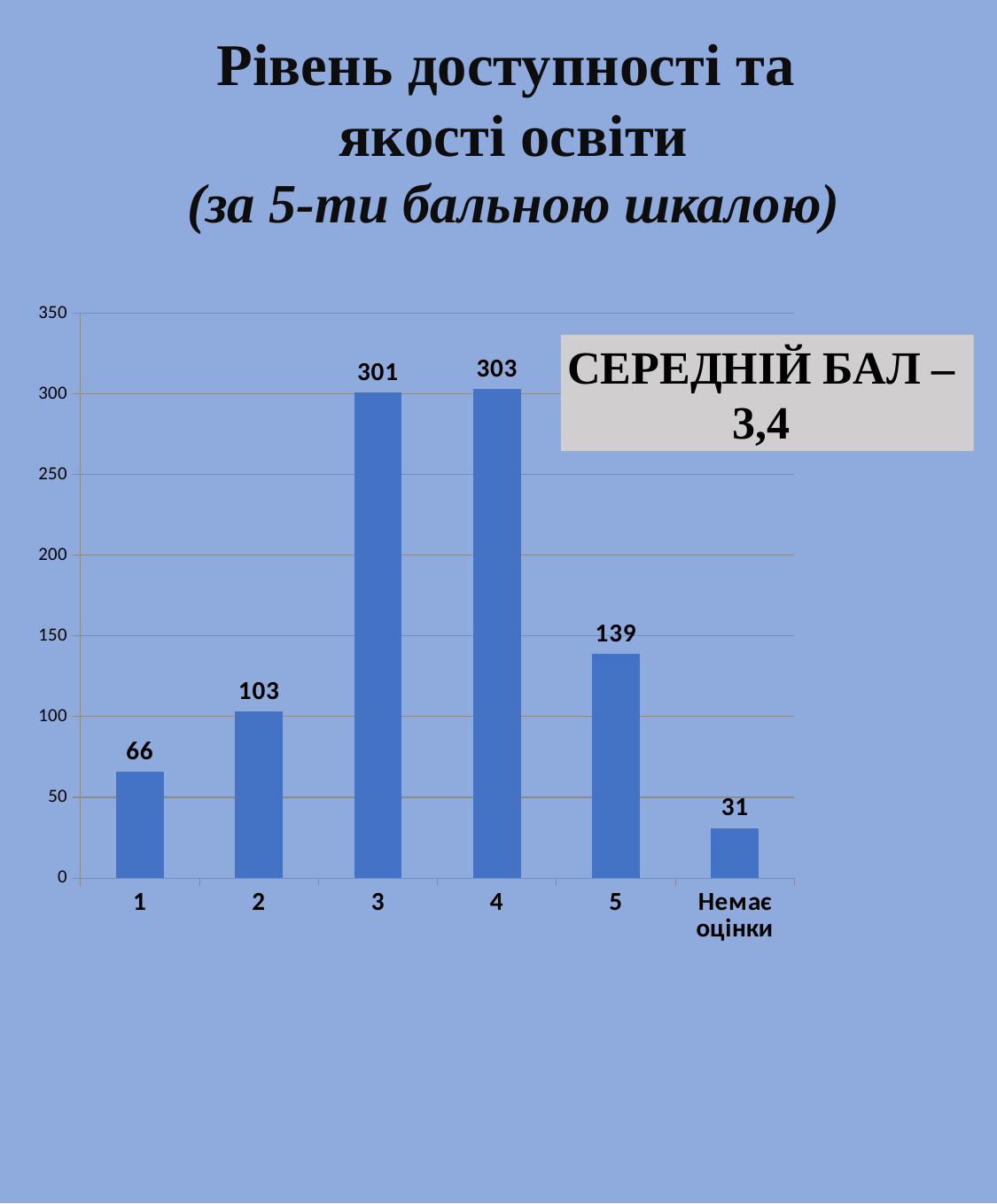
What kind of chart is shown on the slide? bar chart Which category has the highest value? 4 Which is larger, the value for category 2 or the value for category 5? 5 How many categories are shown on the x axis? 6 What is the value for category 5? 139 What is the value for the "Немає оцінки" category? 31 Is the value for category 1 greater or less than 50? greater Which category has the lowest value? Немає оцінки What is the value for category 3? 301 What is the difference between the values for category 4 and category 5? 164 What is the difference between the values for category 2 and category 1? 37 What average score (СЕРЕДНІЙ БАЛ) is stated on the slide? 3,4